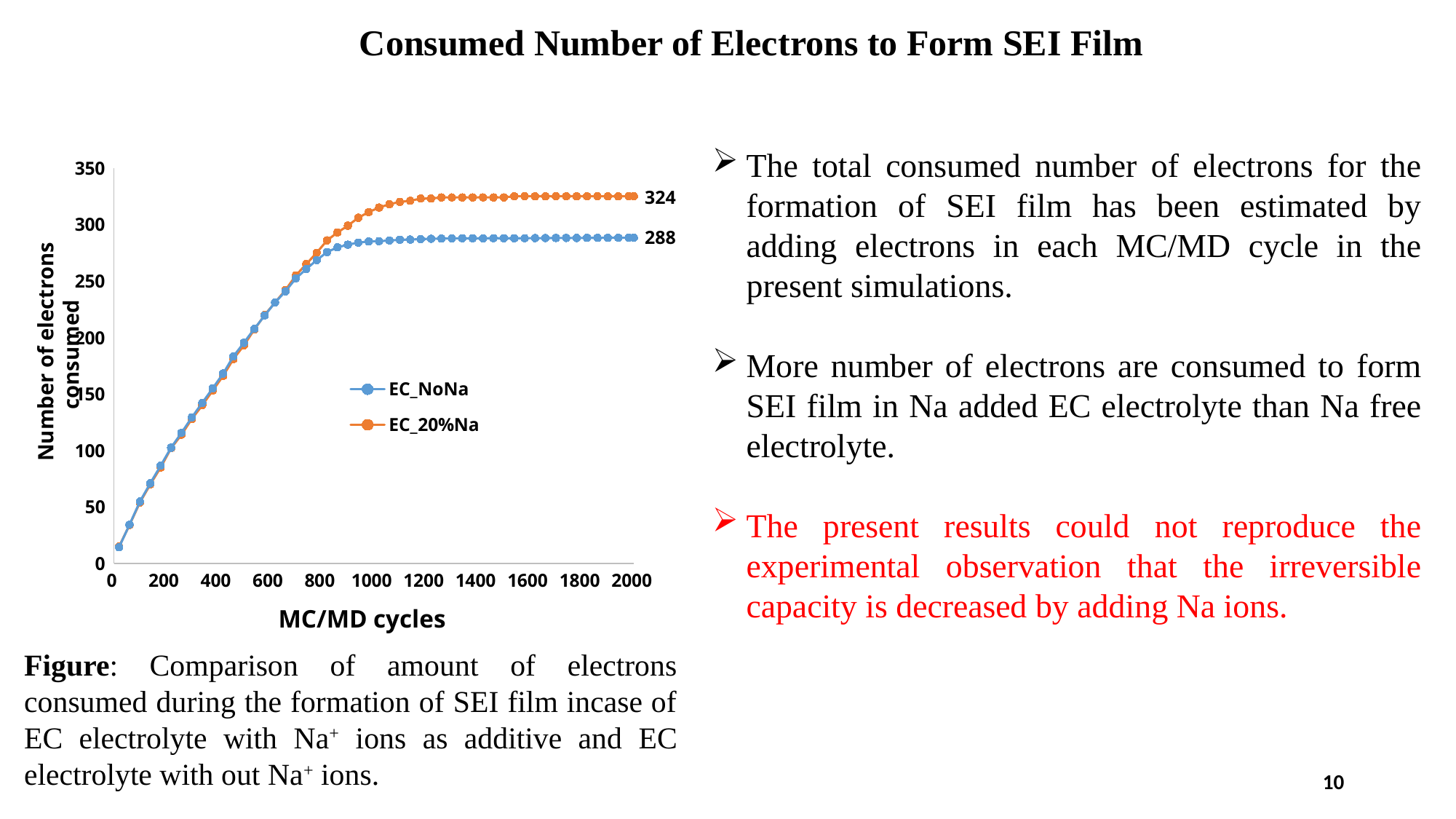
How many series does the legend list? 2 What is the final labelled value of the EC_20%Na series at 2000 MC/MD cycles? 324 Is the value for EC_NoNa at 400 MC/MD cycles greater or less than 200? less What is the title of the y axis of the chart? Number of electrons consumed What is the difference between the final labelled values of EC_20%Na and EC_NoNa? 36 What kind of chart is shown on the slide? Line chart What is the final labelled value of the EC_NoNa series at 2000 MC/MD cycles? 288 Which series reaches the higher final value, EC_NoNa or EC_20%Na? EC_20%Na Do the values of the EC_NoNa series rise or fall as the number of MC/MD cycles increases? Rise Is the value for EC_20%Na at 1200 MC/MD cycles greater or less than 300? greater What is the title of the x axis of the chart? MC/MD cycles Which series has the lowest final value? EC_NoNa